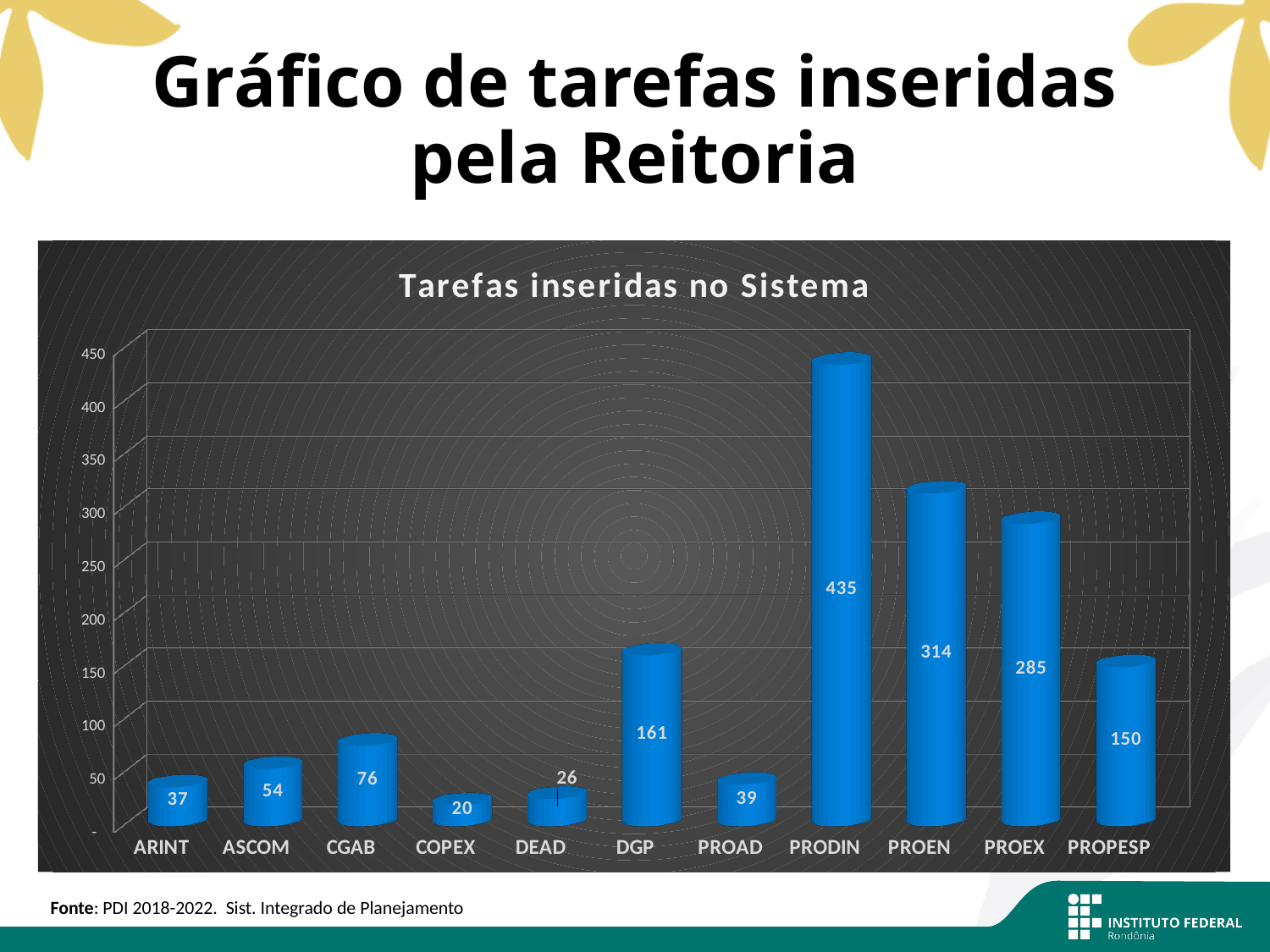
Which is larger, the value for CGAB or the value for ASCOM? CGAB What kind of chart is shown? bar chart What is the value for COPEX? 20 What is the value for PRODIN? 435 What is the value for DEAD? 26 Which category has the highest value? PRODIN What is the value for DGP? 161 Is the value for PROPESP greater or less than 100? greater What is the title of the chart? Tarefas inseridas no Sistema Which category has the lowest value? COPEX How many categories are shown on the x axis? 11 What is the difference between the values for PROEN and PROEX? 29